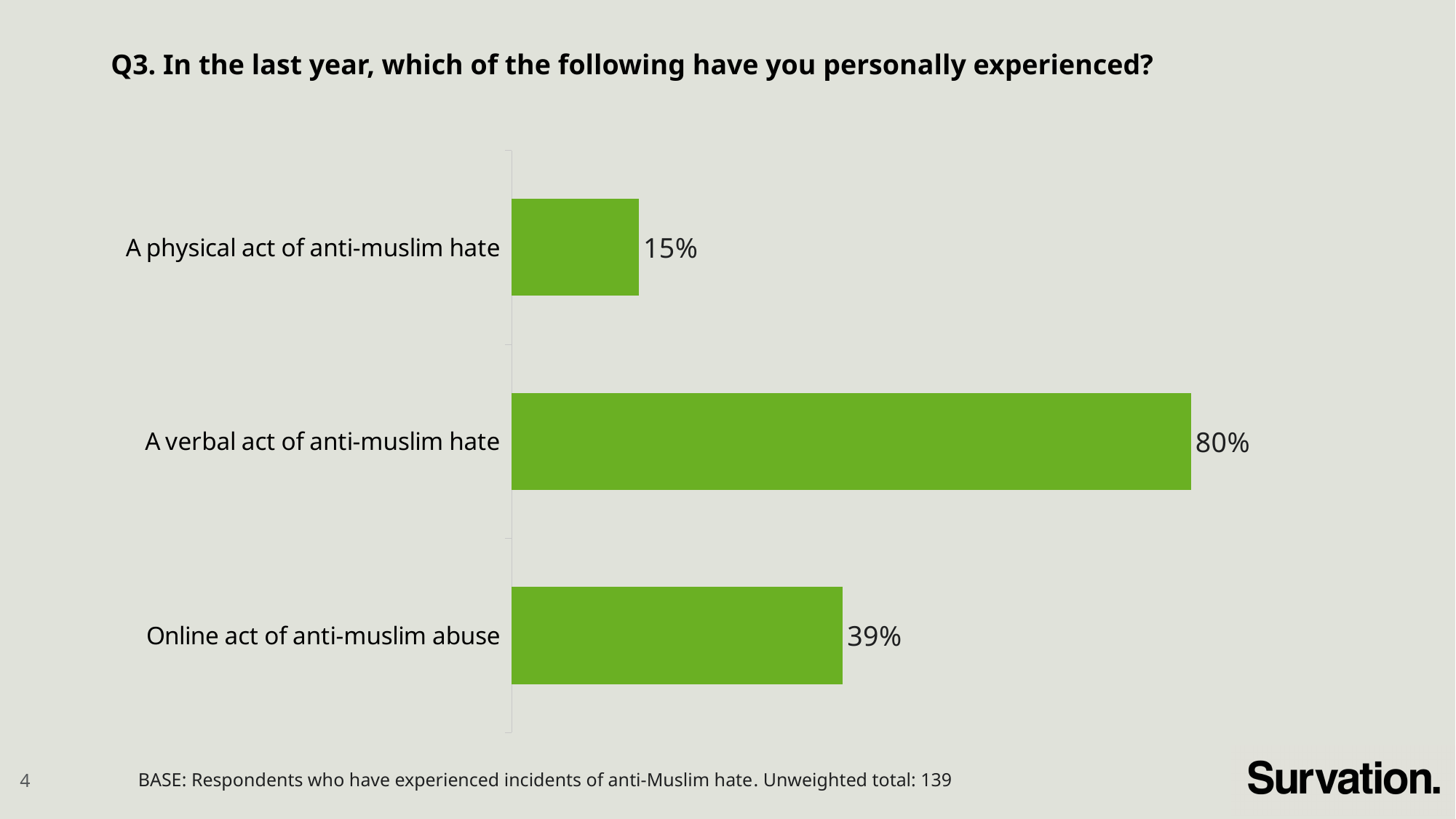
How many categories are shown in the chart? 3 Which category has the highest value? A verbal act of anti-muslim hate What percentage of respondents experienced a physical act of anti-muslim hate? 15% What is the difference between the values for an online act of anti-muslim abuse and a physical act of anti-muslim hate? 24% What percentage of respondents experienced an online act of anti-muslim abuse? 39% What is the unweighted total stated in the base note? 139 What percentage of respondents experienced a verbal act of anti-muslim hate? 80% Which is larger: the value for an online act of anti-muslim abuse or a physical act of anti-muslim hate? Online act of anti-muslim abuse Which category has the lowest value? A physical act of anti-muslim hate What is the difference between the values for a verbal act of anti-muslim hate and an online act of anti-muslim abuse? 41% What is the title of the chart? Q3. In the last year, which of the following have you personally experienced? What kind of chart is shown on the slide? Bar chart